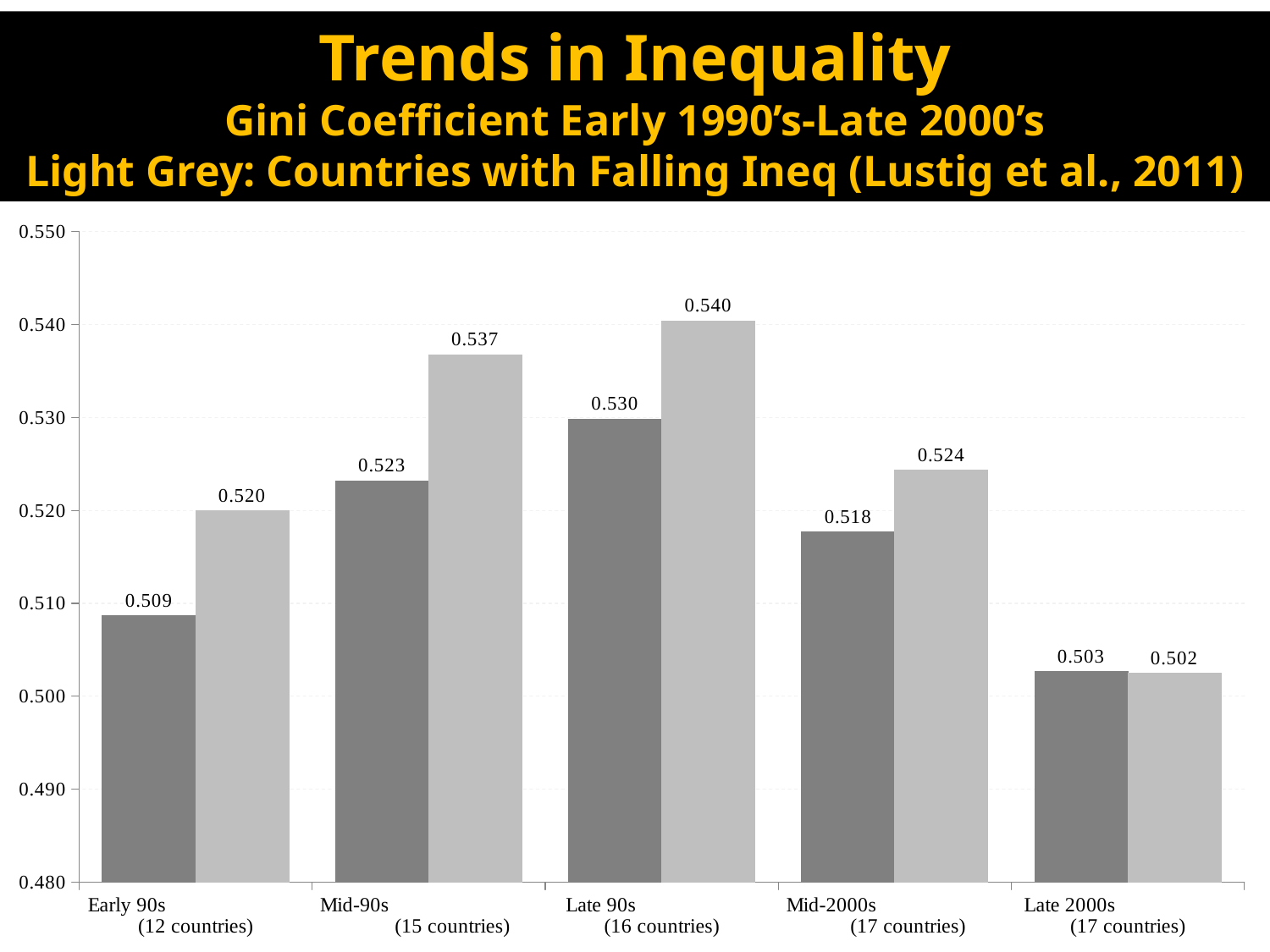
What is the light grey bar value for Late 90s? 0.540 How many period categories are shown on the x axis? 5 According to the slide title, what do the light grey bars represent? Countries with Falling Ineq What is the difference between the light grey and dark grey bars for Mid-90s? 0.014 Is the light grey bar value for Mid-2000s greater or less than 0.520? greater What is the dark grey bar value for Early 90s? 0.509 What is the dark grey bar value for Mid-2000s? 0.518 How many countries are included in the Late 90s category? 16 countries What type of chart is shown on the slide? bar chart Which is larger for Early 90s, the dark grey bar or the light grey bar? light grey bar Which period has the lowest dark grey bar? Late 2000s Which period has the highest light grey bar? Late 90s